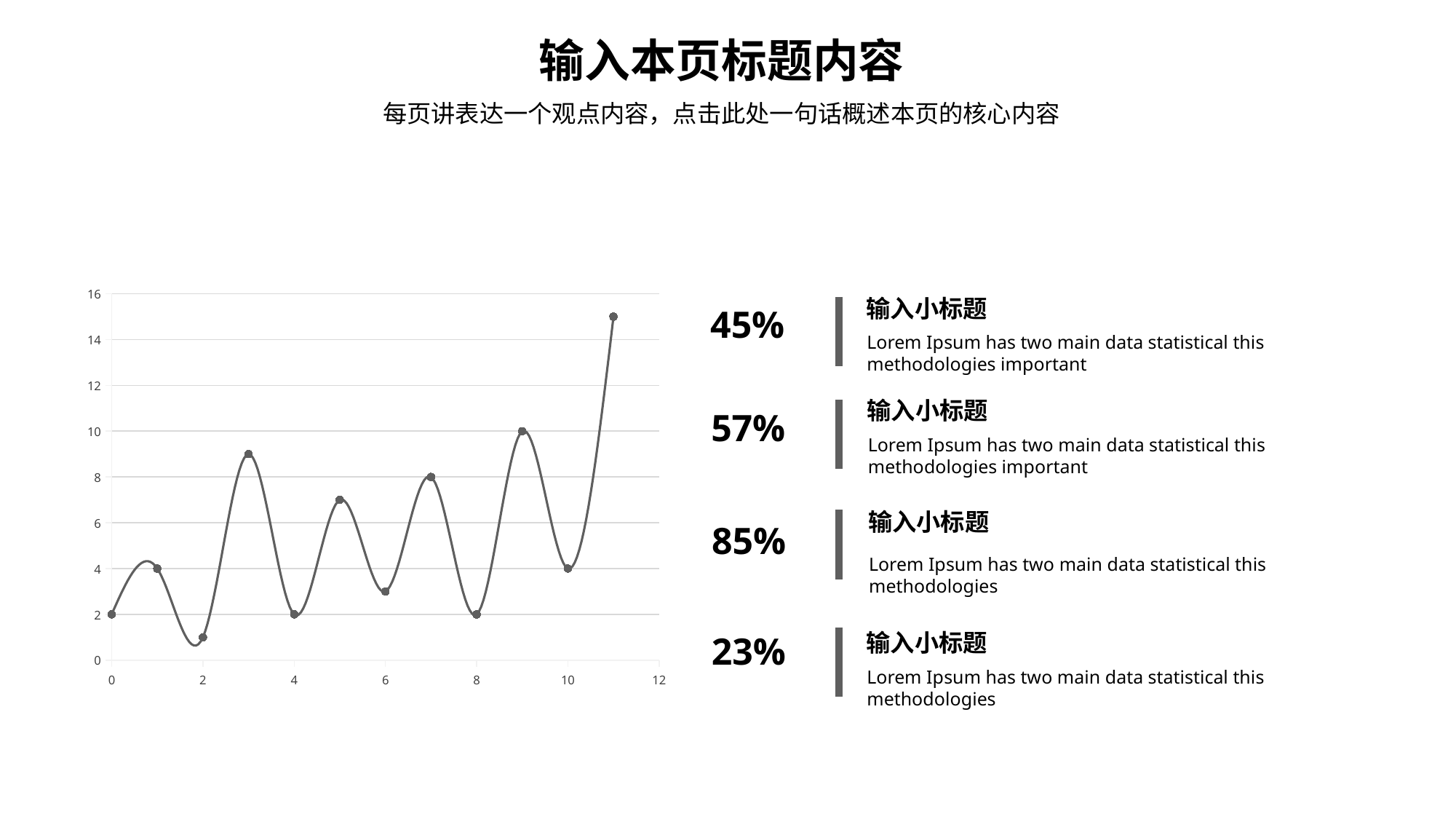
What type of chart is shown on the slide? line chart At which x value does the chart reach its highest point? 11 What is the value of the point at x = 7? 8 Which point has the larger value, the one at x = 9 or the one at x = 7? x = 9 What is the difference between the values at x = 9 and x = 1? 6 Is the value of the point at x = 11 greater or less than 14? greater What is the value of the point at x = 10? 4 Is the value of the point at x = 3 greater or less than 8? greater At which x value does the chart reach its lowest point? 2 What is the value of the point at x = 0? 2 How many data points are plotted on the chart? 12 What is the value of the point at x = 9? 10